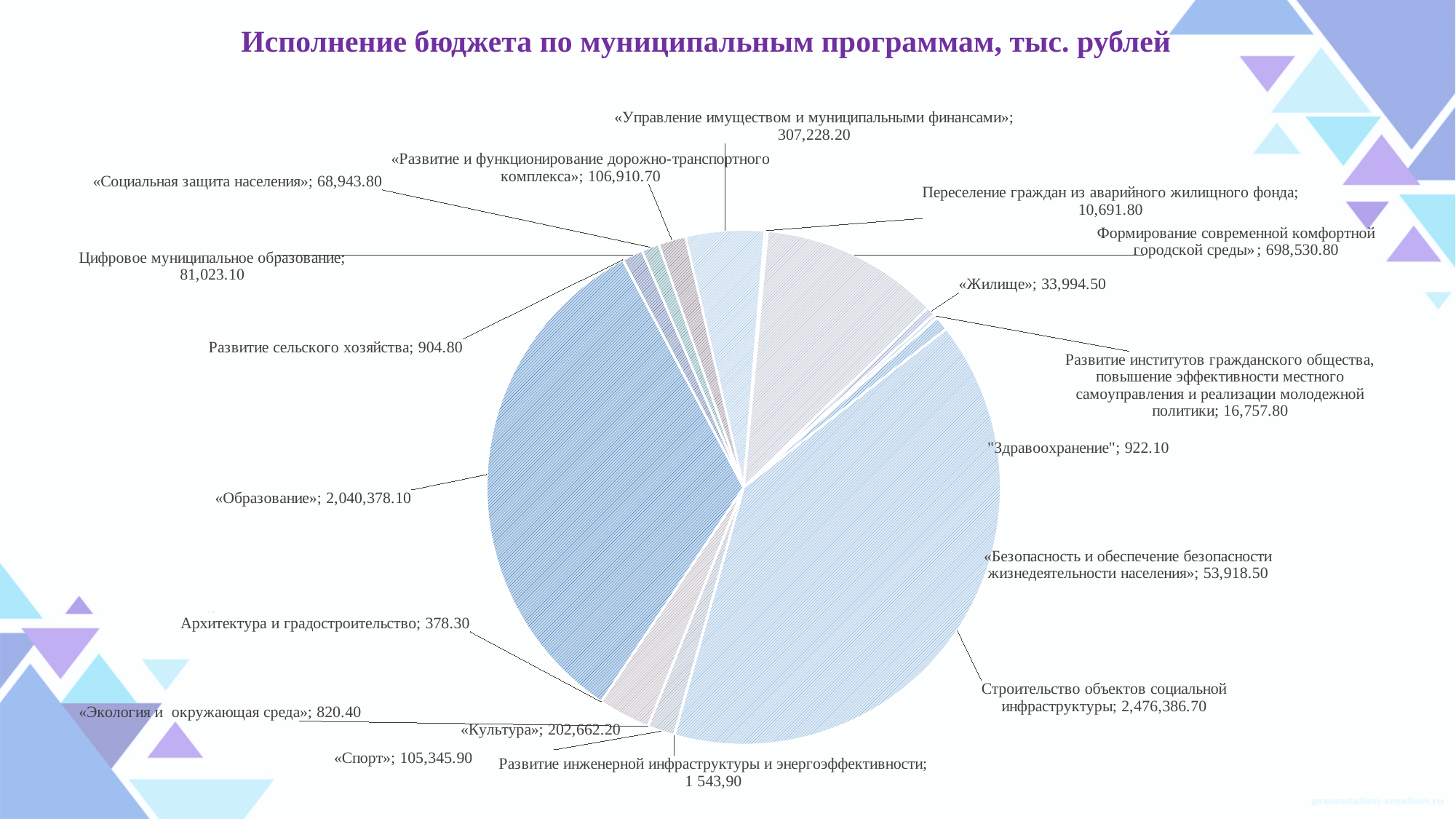
What is the title of the chart? Исполнение бюджета по муниципальным программам, тыс. рублей Which is larger: the value for «Образование» or for Строительство объектов социальной инфраструктуры? Строительство объектов социальной инфраструктуры Which category has the smallest value? Архитектура и градостроительство What is the value for Формирование современной комфортной городской среды? 698,530.80 What is the value for Строительство объектов социальной инфраструктуры? 2,476,386.70 What is the value for «Жилище»? 33,994.50 What kind of chart is shown on the slide? pie chart How many categories does the pie chart show? 18 Which category has the largest value? Строительство объектов социальной инфраструктуры What is the value for «Образование»? 2,040,378.10 What is the difference between the values for «Образование» and «Культура»? 1,837,715.90 What is the difference between the values for Цифровое муниципальное образование and «Социальная защита населения»? 12,079.30